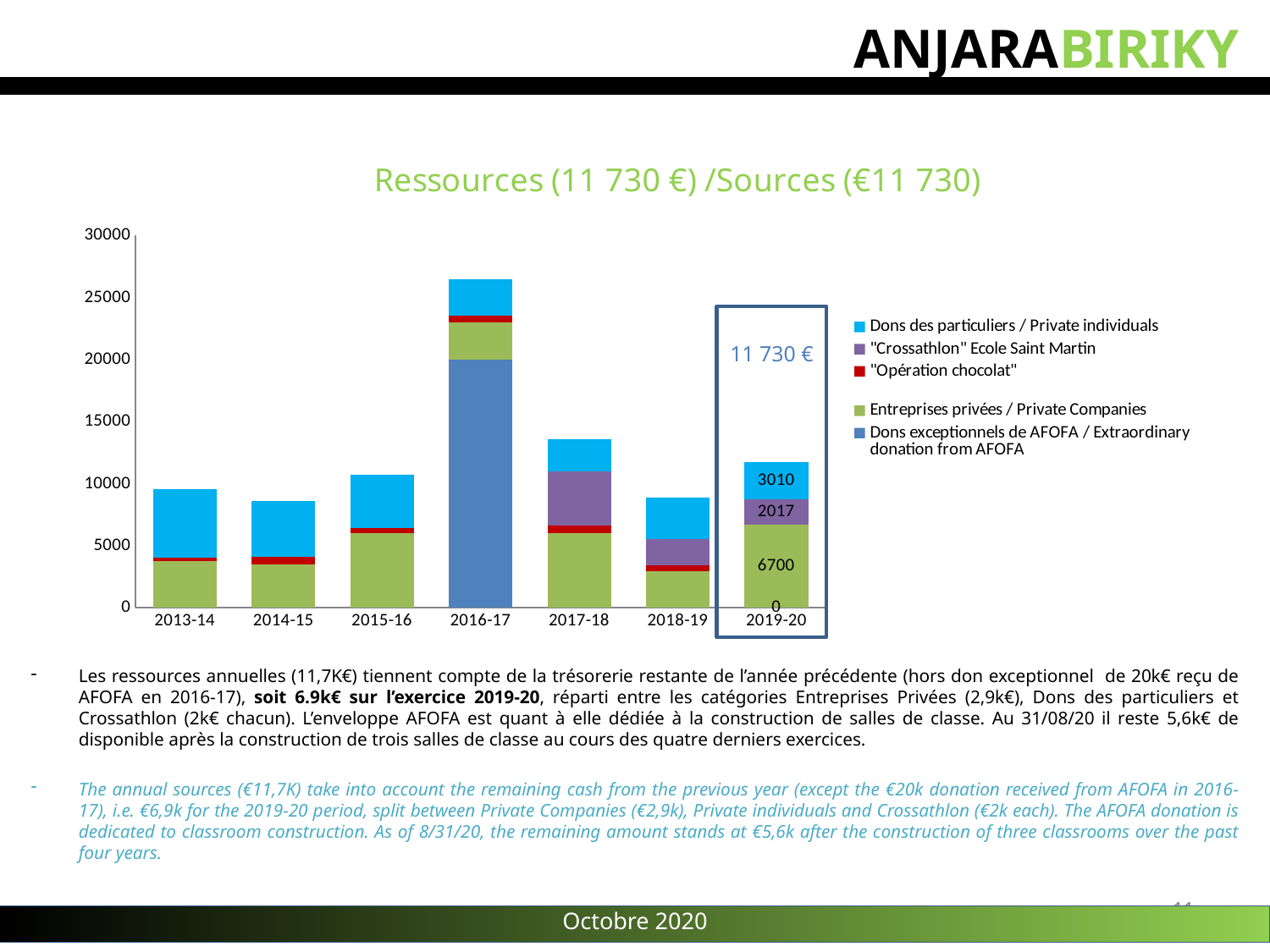
What is the value for Dons des particuliers / Private individuals in 2019-20? 3010 What is the total shown for the 2019-20 stacked bar? 11 730 € What is the value for "Crossathlon" Ecole Saint Martin in 2019-20? 2017 In 2019-20, how much larger is the Entreprises privées value than the Dons des particuliers value? 3690 How many series does the legend list? 5 Is the total for 2013-14 greater or less than 10000? less In 2019-20, which is larger: Entreprises privées or Dons des particuliers? Entreprises privées What is the value for Entreprises privées / Private Companies in 2019-20? 6700 How many years are shown on the x axis? 7 What kind of chart is shown on the slide? Stacked bar chart Is the total for 2016-17 greater or less than 25000? greater Which year has the highest total bar? 2016-17